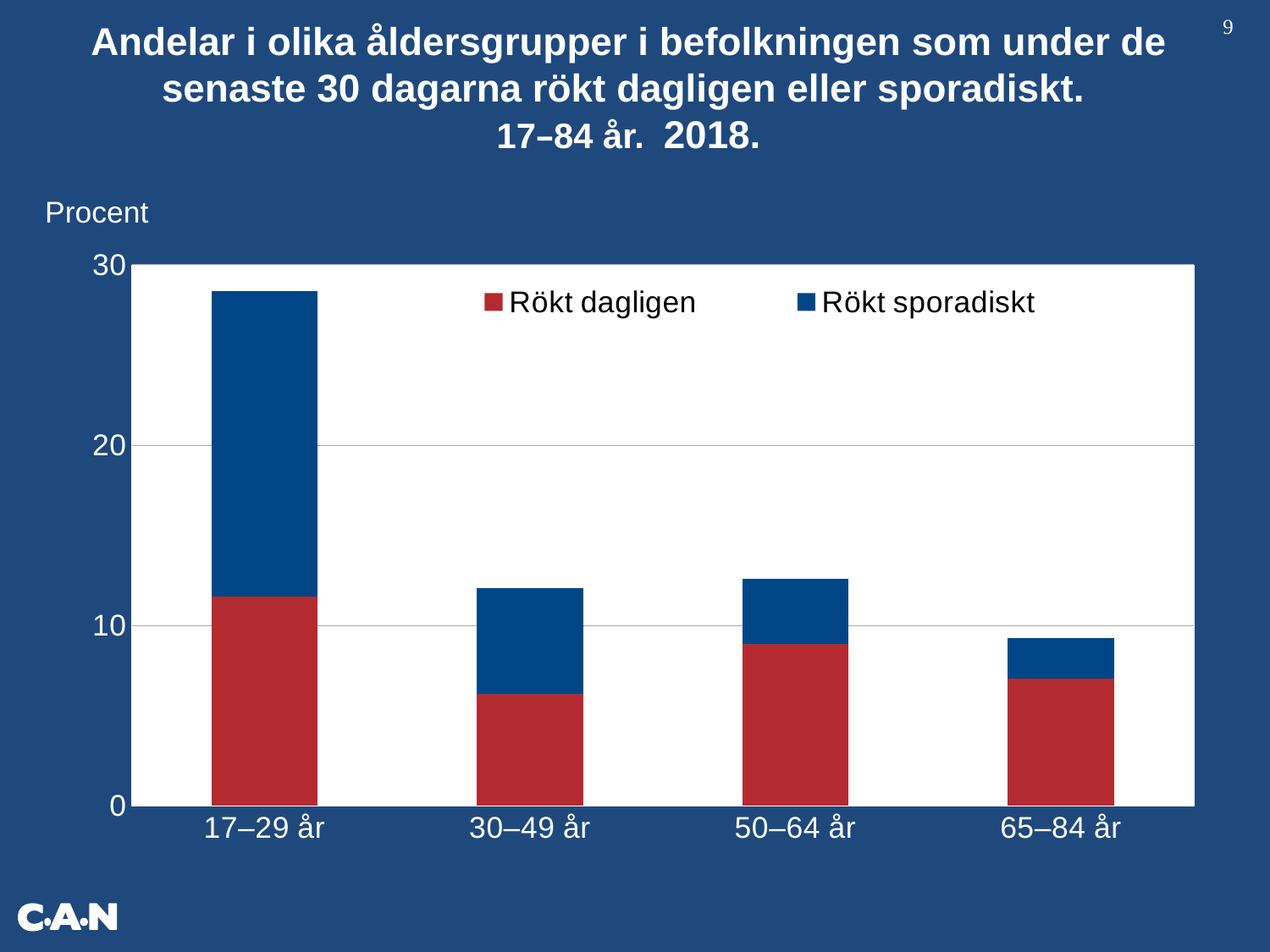
How many series does the legend list? 2 How many age groups are shown on the x axis? 4 Is the Rökt dagligen value for 30–49 år greater or less than 10? less Is the Rökt dagligen value for 17–29 år greater or less than 10? greater Which colour represents Rökt dagligen in the chart? Red Is the total bar for 65–84 år greater or less than 10? less Which is larger, the Rökt dagligen value for 50–64 år or for 30–49 år? 50–64 år Which age group has the highest total bar? 17–29 år Which age group has the highest value for Rökt dagligen? 17–29 år What kind of chart is shown on the slide? Stacked bar chart Which age group has the lowest total bar? 65–84 år